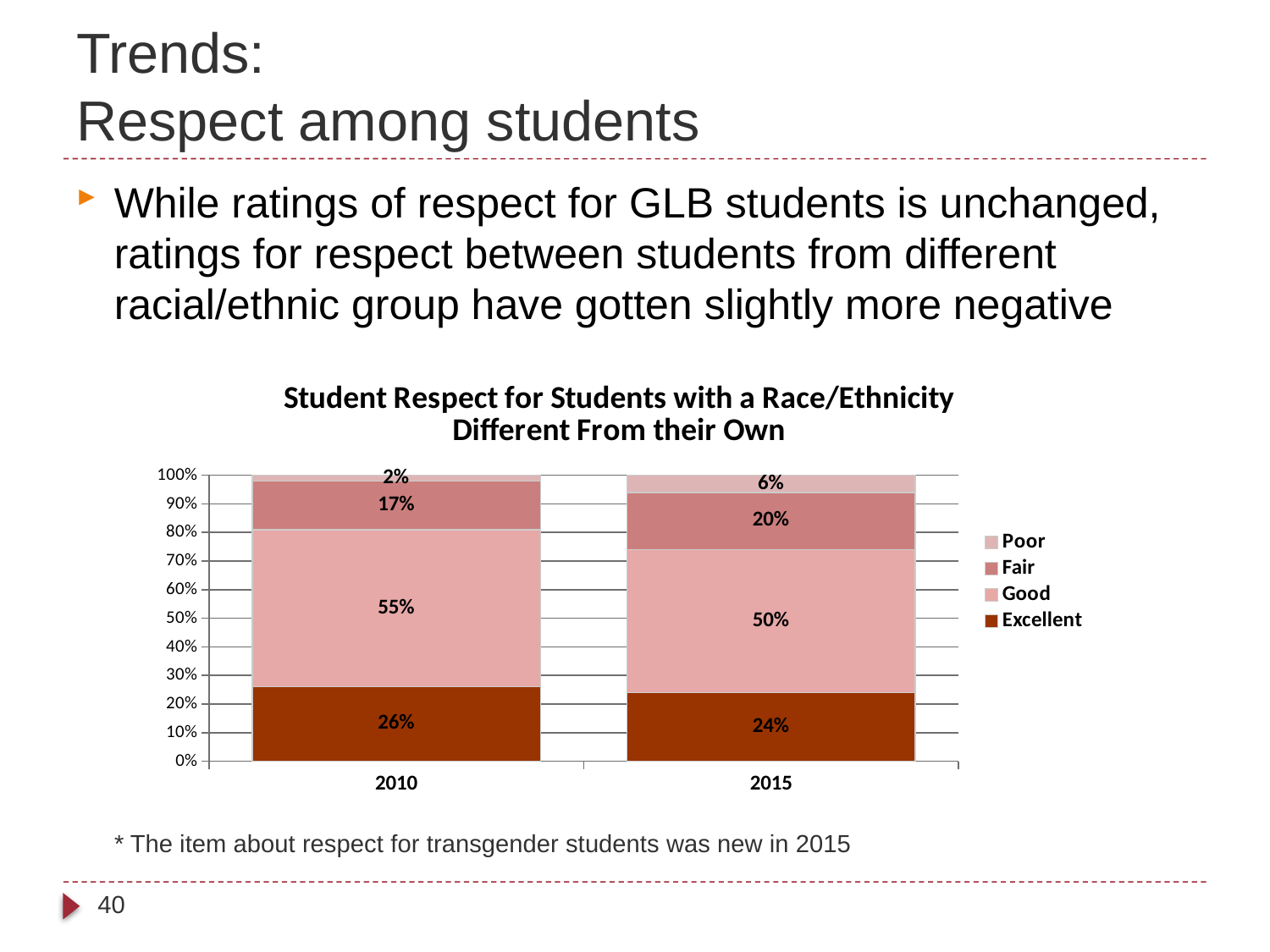
What percentage of students rated respect as Poor in 2015? 6% What type of chart is shown? Stacked bar chart Which rating category has the smallest share in 2015? Poor Which year has the higher Poor percentage, 2010 or 2015? 2015 What percentage of students rated respect as Excellent in 2010? 26% What is the Good value for 2015? 50% How many series does the legend list? 4 Which rating category has the largest share in 2010? Good By how many percentage points did the Good rating change from 2010 to 2015? 5% What is the Fair value for 2010? 17% What is the difference between the Fair values for 2015 and 2010? 3% How many years are shown on the x axis? 2